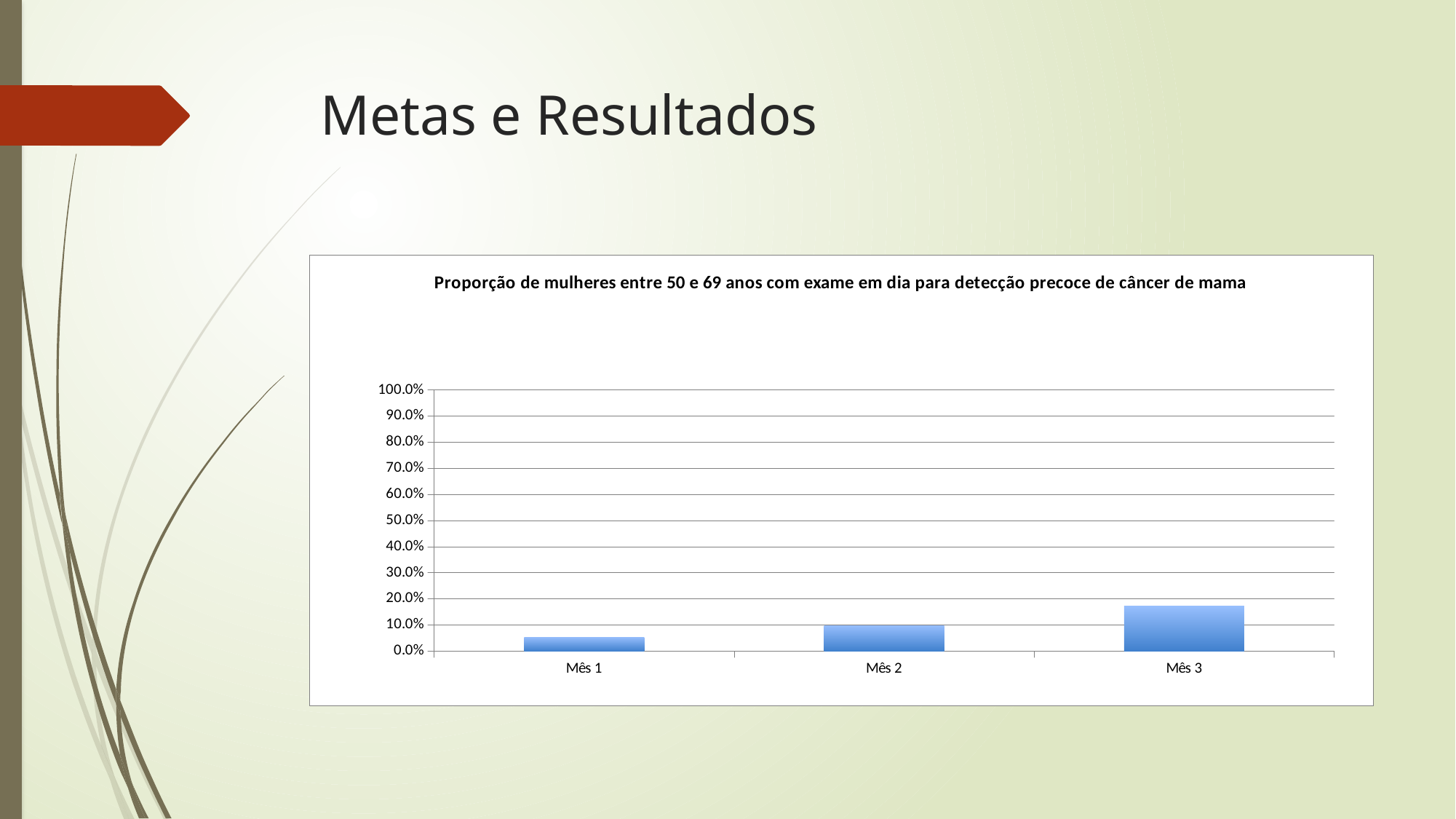
What is the title of the chart? Proporção de mulheres entre 50 e 69 anos com exame em dia para detecção precoce de câncer de mama Which month has the highest value on the chart? Mês 3 Is the value for Mês 2 greater or less than 50.0%? less Is the value for Mês 1 greater or less than 10.0%? less Which is larger, the value for Mês 1 or the value for Mês 3? Mês 3 Do the values rise or fall from Mês 1 to Mês 3? rise What kind of chart is shown on the slide? bar chart What is the maximum value shown on the vertical axis of the chart? 100.0% Is the value for Mês 3 greater or less than 20.0%? less How many categories (months) are plotted on the chart? 3 Which month has the lowest value on the chart? Mês 1